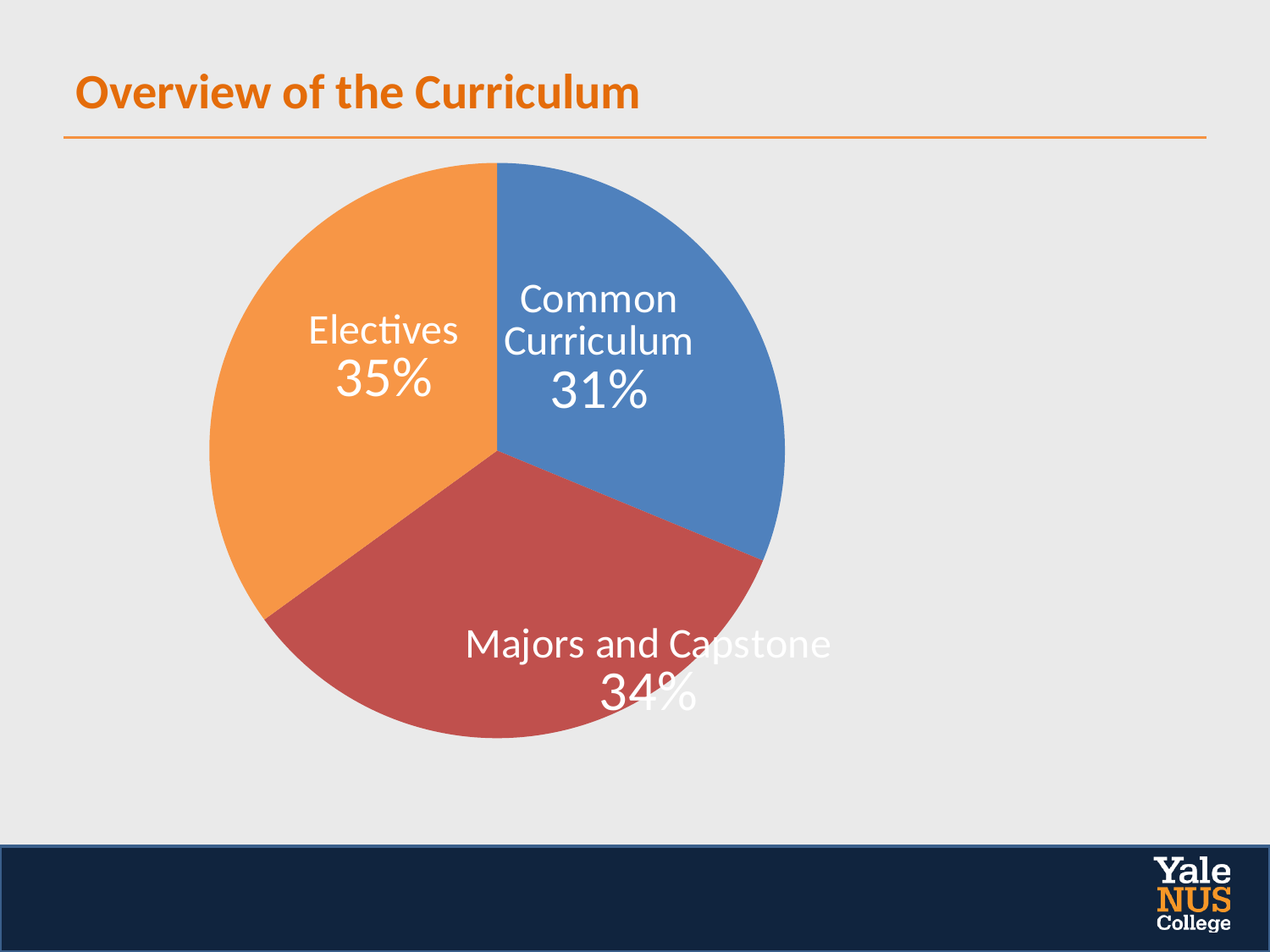
What colour is the Majors and Capstone slice? red Which is larger, the Majors and Capstone share or the Common Curriculum share? Majors and Capstone What is the difference between the Majors and Capstone share and the Common Curriculum share? 3% Which slice of the pie is the smallest? Common Curriculum What share of the pie does Electives take? 35% What share of the pie does Majors and Capstone take? 34% What kind of chart is shown on the slide? pie chart What is the difference between the Electives share and the Common Curriculum share? 4% Which slice of the pie is the largest? Electives What share of the pie does Common Curriculum take? 31% How many slices does the pie chart have? 3 What is the title of the slide containing the pie chart? Overview of the Curriculum